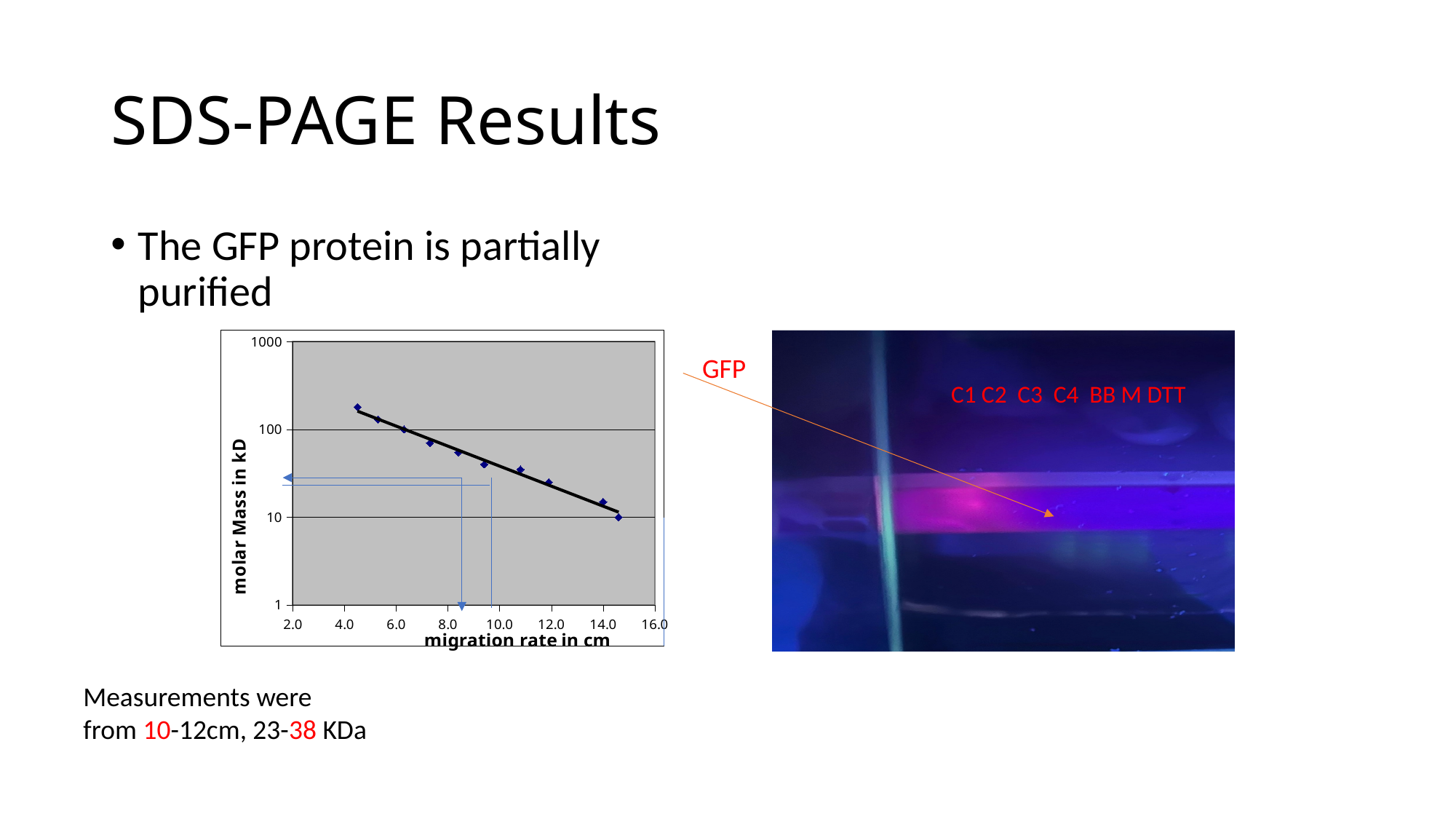
Do the plotted molar mass values rise or fall as the migration rate increases along the x axis? fall What is the highest tick value shown on the y axis of the chart? 1000 What is the title of the x axis of the chart? migration rate in cm What is the title of the y axis of the chart? molar Mass in kD What kind of chart is shown on the slide? scatter chart Is the molar mass of the point at a migration rate of about 8.3 cm greater or less than 10? greater Is the molar mass of the point at the smallest migration rate (about 4.5 cm) greater or less than 100? greater Is the molar mass of the point at a migration rate of about 14.0 cm greater or less than 10? greater How many data points are plotted on the chart? 10 Which point has the highest molar mass: the one at about 4.5 cm or the one at about 14.6 cm migration rate? the one at about 4.5 cm